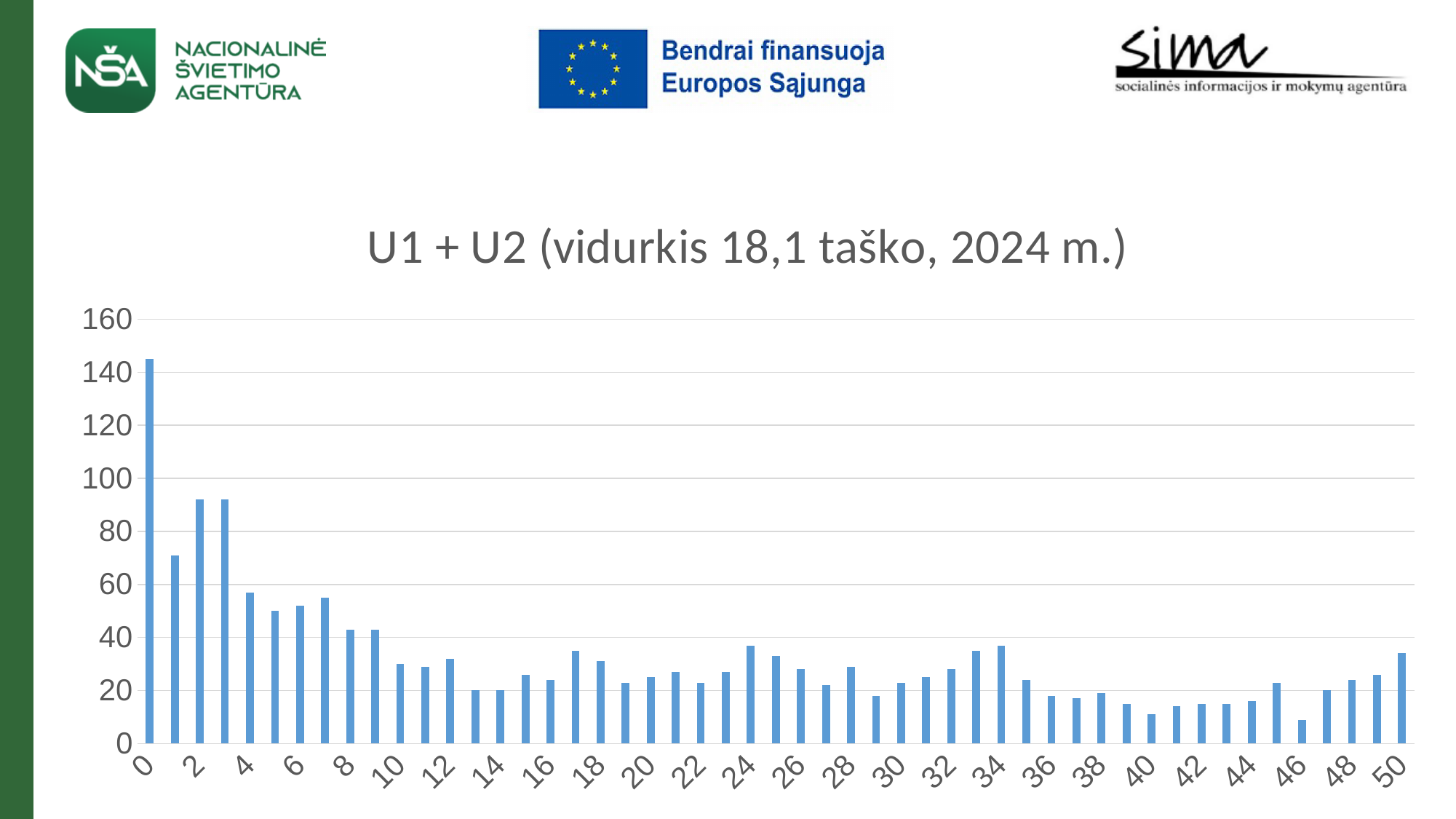
Which has the larger value, category 10 or category 14? 10 What kind of chart is shown on the slide? bar chart Which has the larger value, category 0 or category 2? 0 Is the value for category 46 greater or less than 20? less Is the value for category 10 greater or less than 40? less Is the value for category 0 greater or less than 120? greater Overall, do the bar values rise or fall as the x axis goes from 0 to 50? fall Which category on the x axis has the highest bar? 0 Which has the larger value, category 46 or category 50? 50 What is the title of the chart? U1 + U2 (vidurkis 18,1 taško, 2024 m.)